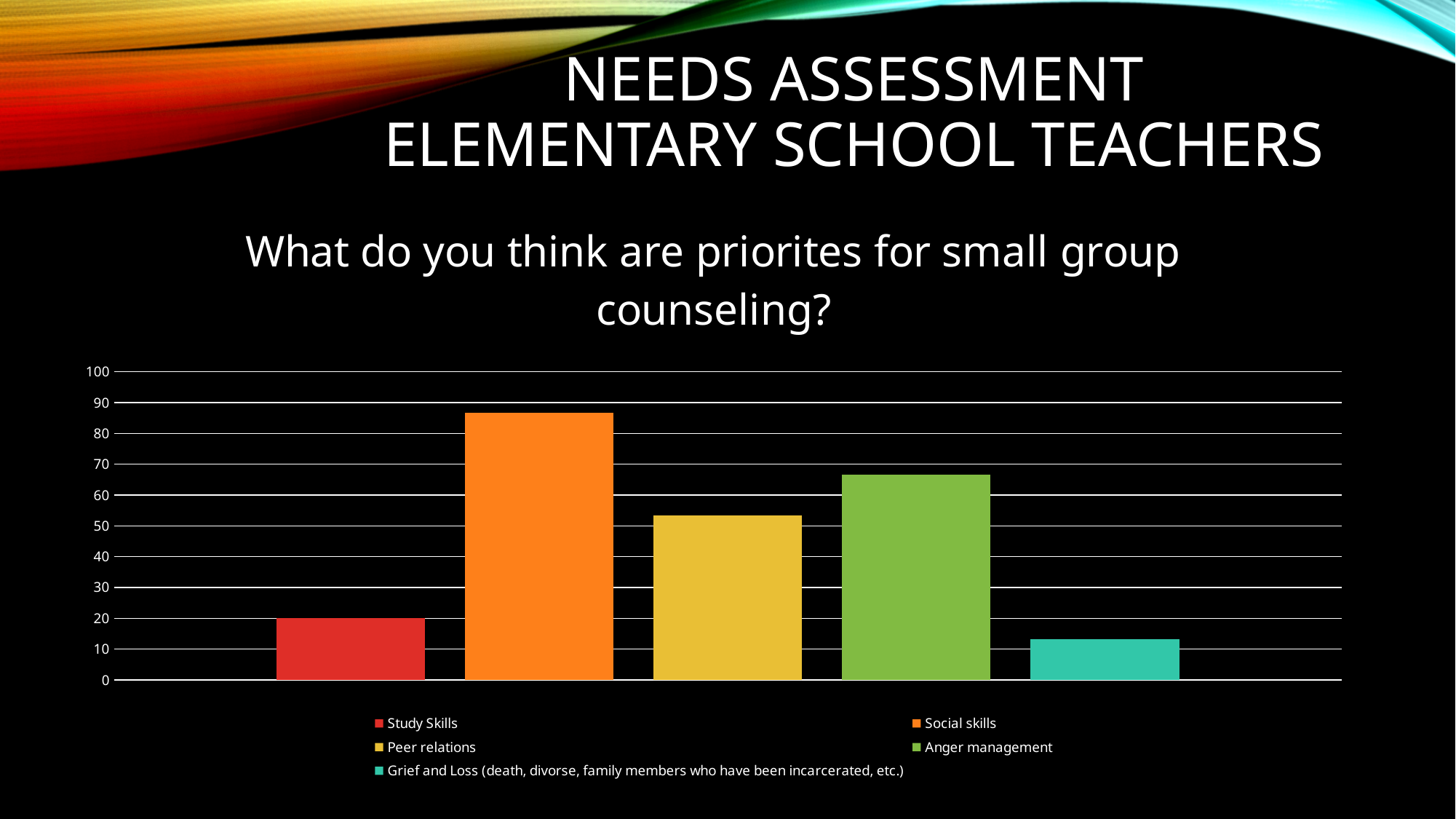
Is the value for Peer relations greater or less than 50? greater What kind of chart is shown on the slide? bar chart Which category has the highest bar? Social skills Is the value for Grief and Loss greater or less than 20? less Is the value for Anger management greater or less than 70? less Which category has the lowest bar? Grief and Loss (death, divorse, family members who have been incarcerated, etc.) How many entries does the legend list? 5 What colour is the bar for Social skills? orange Which is larger, the value for Anger management or the value for Peer relations? Anger management How many bars are plotted in the chart? 5 Which is larger, the value for Study Skills or the value for Grief and Loss? Study Skills